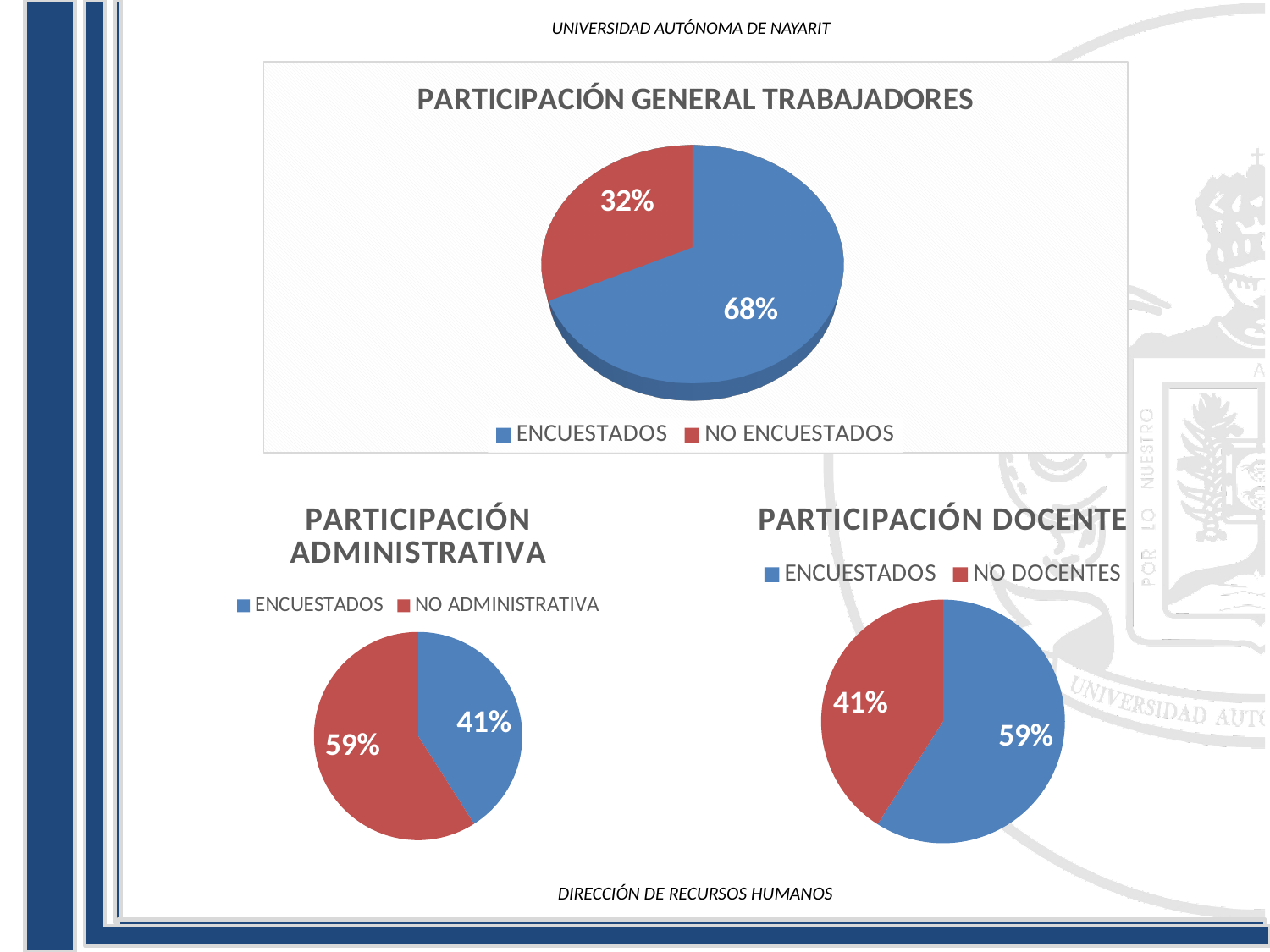
In the 'PARTICIPACIÓN DOCENTE' chart, what share of the pie is NO DOCENTES? 41% In the 'PARTICIPACIÓN DOCENTE' chart, what share of the pie is ENCUESTADOS? 59% In the 'PARTICIPACIÓN GENERAL TRABAJADORES' chart, what share of the pie is ENCUESTADOS? 68% In the 'PARTICIPACIÓN ADMINISTRATIVA' chart, which slice is the smallest? ENCUESTADOS In the 'PARTICIPACIÓN GENERAL TRABAJADORES' chart, what is the difference between the ENCUESTADOS and NO ENCUESTADOS shares? 36% How many entries does the legend of the 'PARTICIPACIÓN ADMINISTRATIVA' chart list? 2 In the 'PARTICIPACIÓN GENERAL TRABAJADORES' chart, which slice is the largest? ENCUESTADOS In the 'PARTICIPACIÓN DOCENTE' chart, which is larger, ENCUESTADOS or NO DOCENTES? ENCUESTADOS What kind of chart is the 'PARTICIPACIÓN DOCENTE' chart? Pie chart